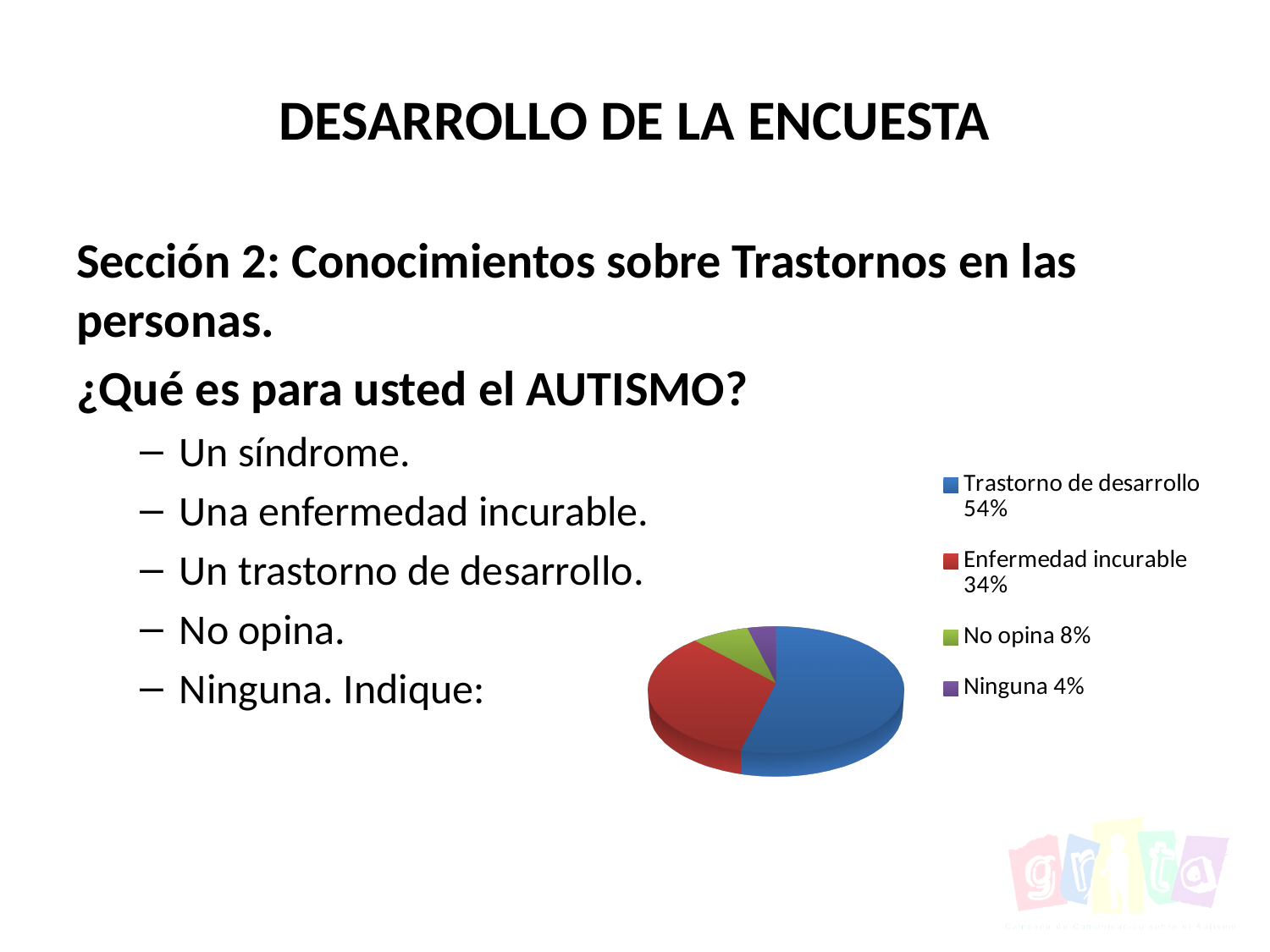
How many categories does the pie chart show? 4 What colour is the slice for "Trastorno de desarrollo"? Blue What colour is the slice for "Enfermedad incurable"? Red Which category has the largest share of the pie? Trastorno de desarrollo What percentage of respondents answered "Ninguna"? 4% What percentage of respondents answered "No opina"? 8% What percentage of respondents answered "Trastorno de desarrollo"? 54% Which category has the smallest share of the pie? Ninguna What is the difference in percentage points between "Trastorno de desarrollo" and "Enfermedad incurable"? 20 What kind of chart is shown on the slide? Pie chart What percentage of respondents answered "Enfermedad incurable"? 34% Which is larger, the share for "No opina" or the share for "Ninguna"? No opina